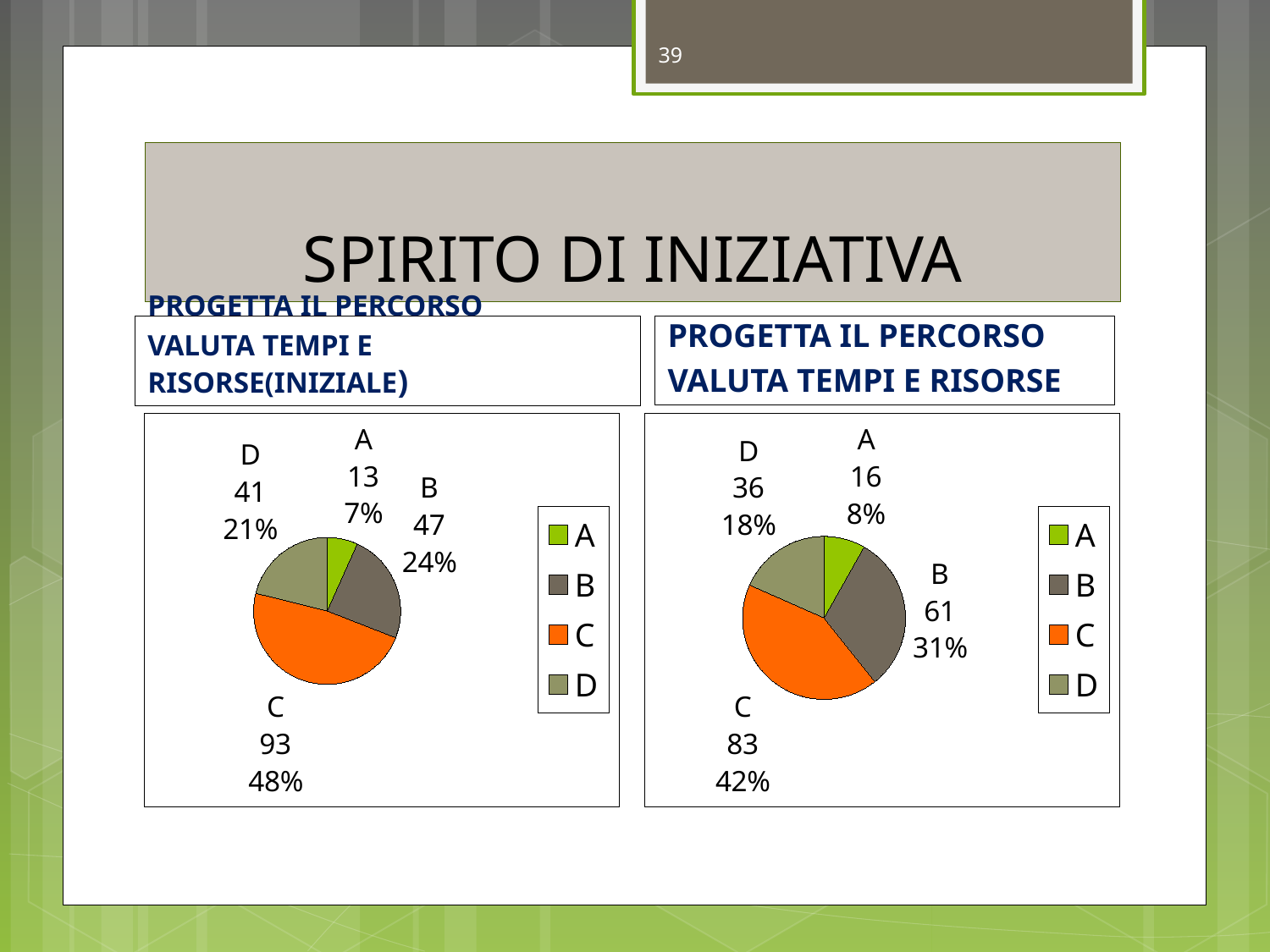
In the right pie chart, what is the difference between the values for C and B? 22 In the right pie chart, which category has the smallest slice? A In the right pie chart, what percentage share does category D have? 18% In the left pie chart (INIZIALE), what is the value for category C? 93 In the left pie chart (INIZIALE), what percentage share does category B have? 24% In the left pie chart (INIZIALE), what is the value for category A? 13 What type of chart is shown on the right side of the slide? Pie chart In the left pie chart (INIZIALE), which category has the largest slice? C In the right pie chart (PROGETTA IL PERCORSO VALUTA TEMPI E RISORSE), what is the value for category B? 61 In the left pie chart (INIZIALE), which is larger, the value for D or the value for B? B In the right pie chart, what colour is the slice for category C? Orange How many slices does the left pie chart (INIZIALE) have? 4